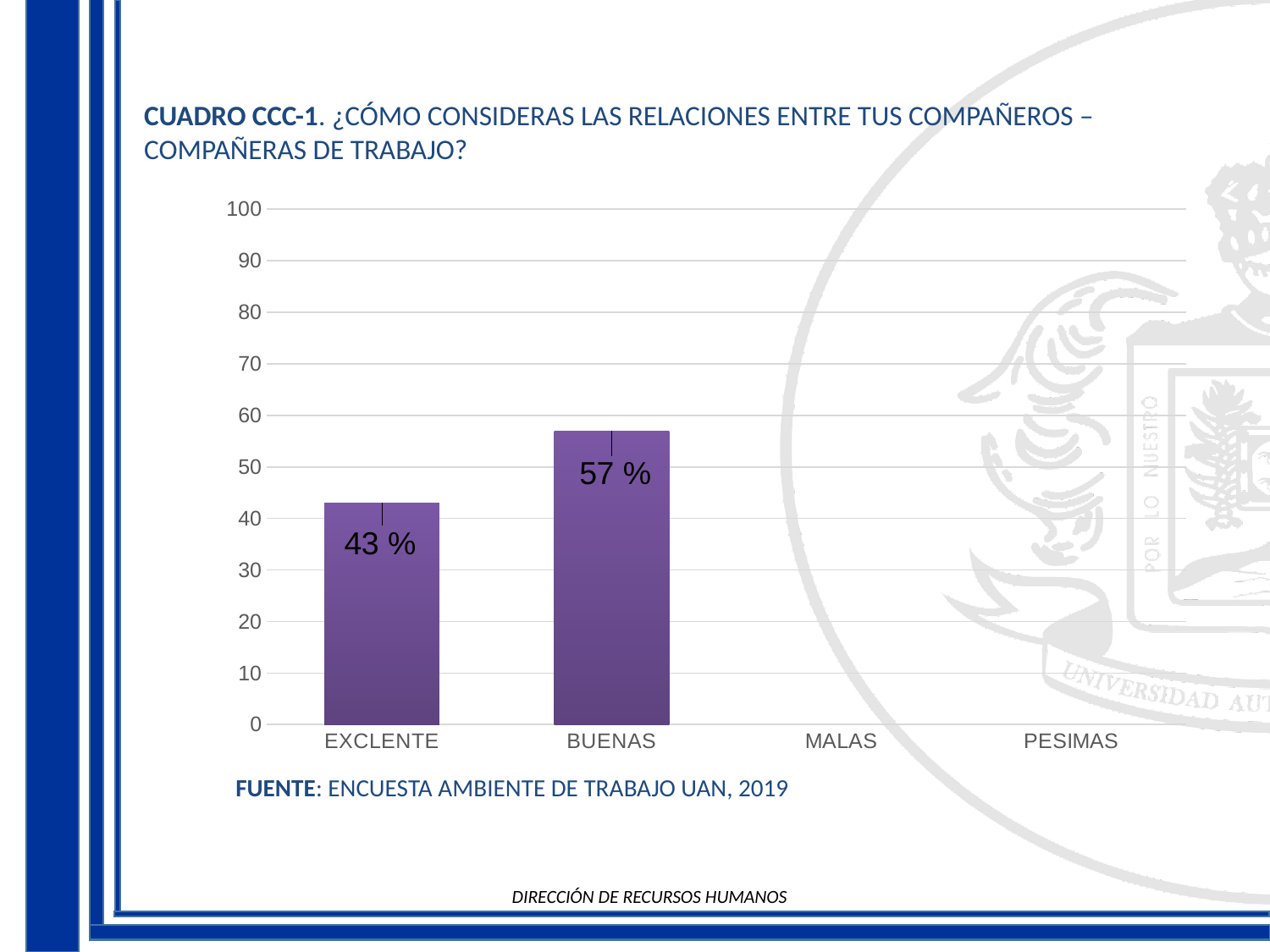
Which is larger, the value for EXCLENTE or the value for BUENAS? BUENAS Which categories have no visible bar? MALAS and PESIMAS Is the value for EXCLENTE greater or less than 50? less What kind of chart is shown on the slide? bar chart Is the value for BUENAS greater or less than 50? greater Which category has the highest value? BUENAS What is the value for BUENAS? 57 % What is the difference between the values for BUENAS and EXCLENTE? 14 % How many categories are shown on the x axis? 4 What is the value for EXCLENTE? 43 % What is the maximum value shown on the y axis? 100